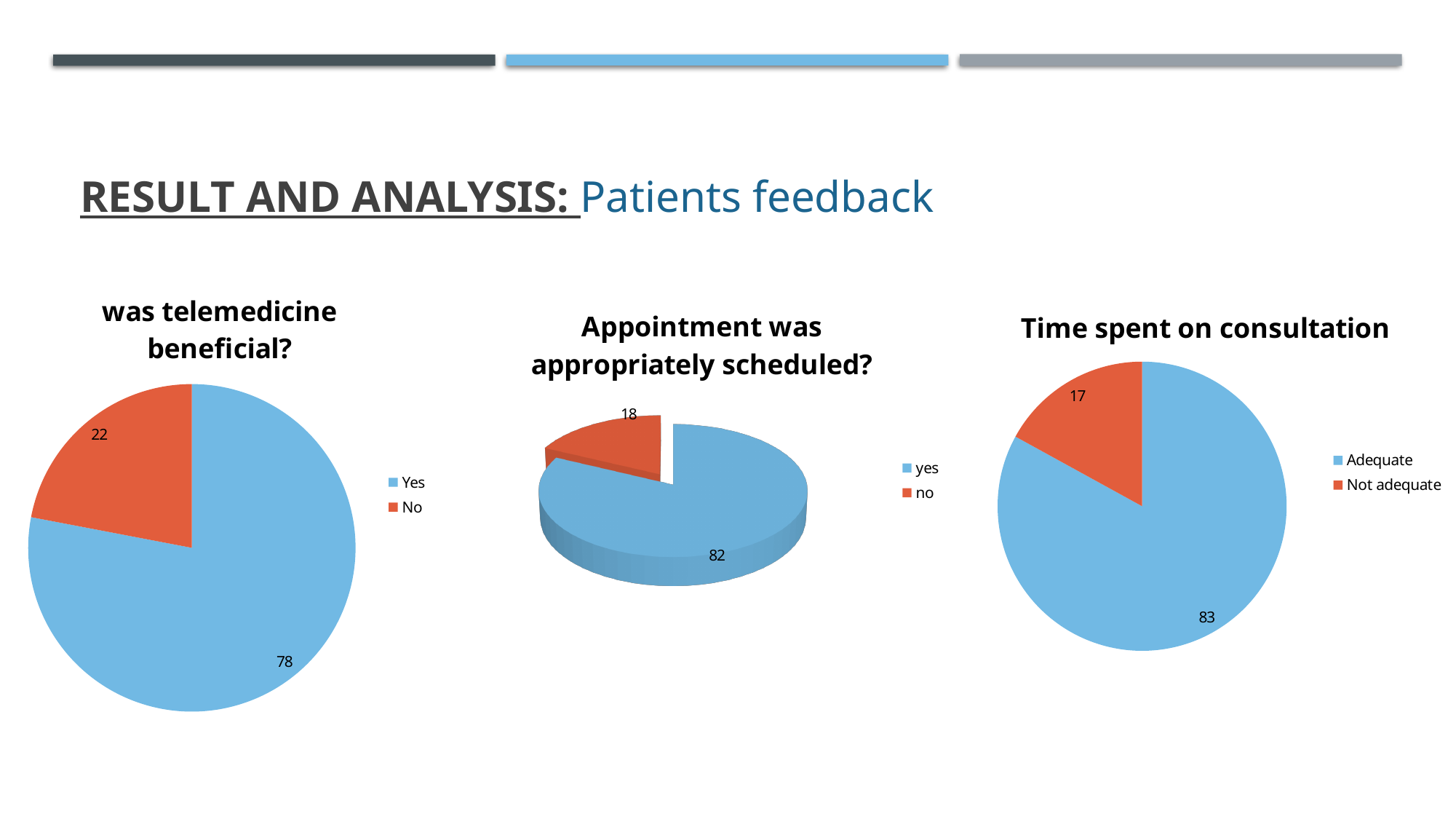
In the 'Appointment was appropriately scheduled?' chart, which is larger, yes or no? yes How many entries does the legend of the 'Time spent on consultation' chart list? 2 In the 'was telemedicine beneficial?' chart, what is the difference between the Yes and No values? 56 In the 'Appointment was appropriately scheduled?' chart, which category has the largest slice? yes In the 'was telemedicine beneficial?' chart, what is the value for No? 22 How many slices does the 'was telemedicine beneficial?' chart have? 2 In the 'Time spent on consultation' chart, what is the value for Adequate? 83 In the 'was telemedicine beneficial?' chart, what is the value for Yes? 78 What kind of chart is 'Time spent on consultation'? Pie chart In the 'Time spent on consultation' chart, which category has the smallest slice? Not adequate In the 'Appointment was appropriately scheduled?' chart, what is the value for no? 18 In the 'Time spent on consultation' chart, what is the difference between Adequate and Not adequate? 66